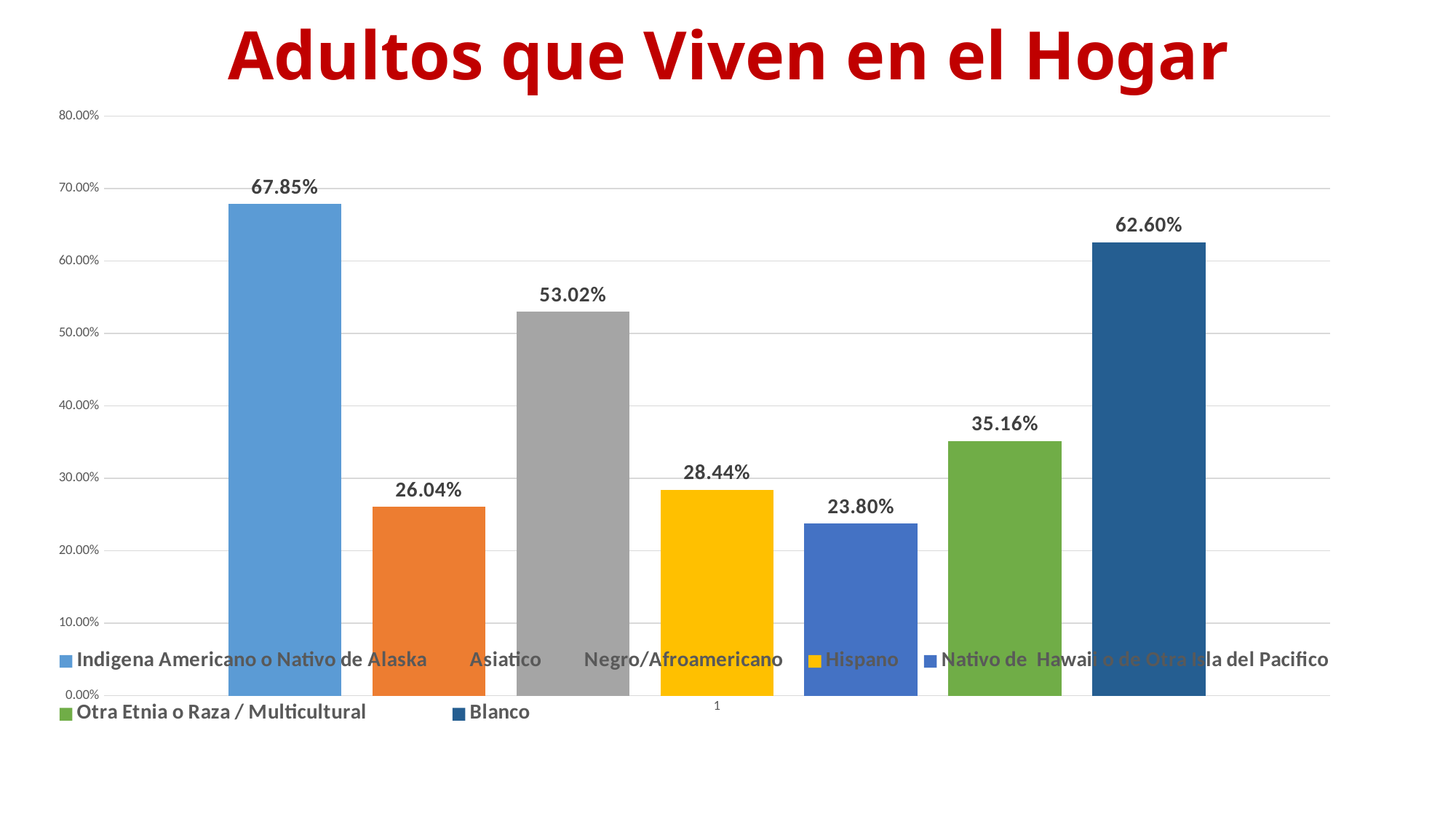
Which category has the highest value? Indigena Americano o Nativo de Alaska What kind of chart is shown on the slide? bar chart What is the difference between the values for Indigena Americano o Nativo de Alaska and Blanco? 5.25% Is the value for Asiatico greater or less than 30.00%? less What is the value for Otra Etnia o Raza / Multicultural? 35.16% Which is larger, the value for Negro/Afroamericano or the value for Otra Etnia o Raza / Multicultural? Negro/Afroamericano Which category has the lowest value? Nativo de Hawaii o de Otra Isla del Pacifico What is the value for Hispano? 28.44% What is the value for Indigena Americano o Nativo de Alaska? 67.85% How many bars are shown in the chart? 7 What is the value for Blanco? 62.60% What is the title of the chart? Adultos que Viven en el Hogar